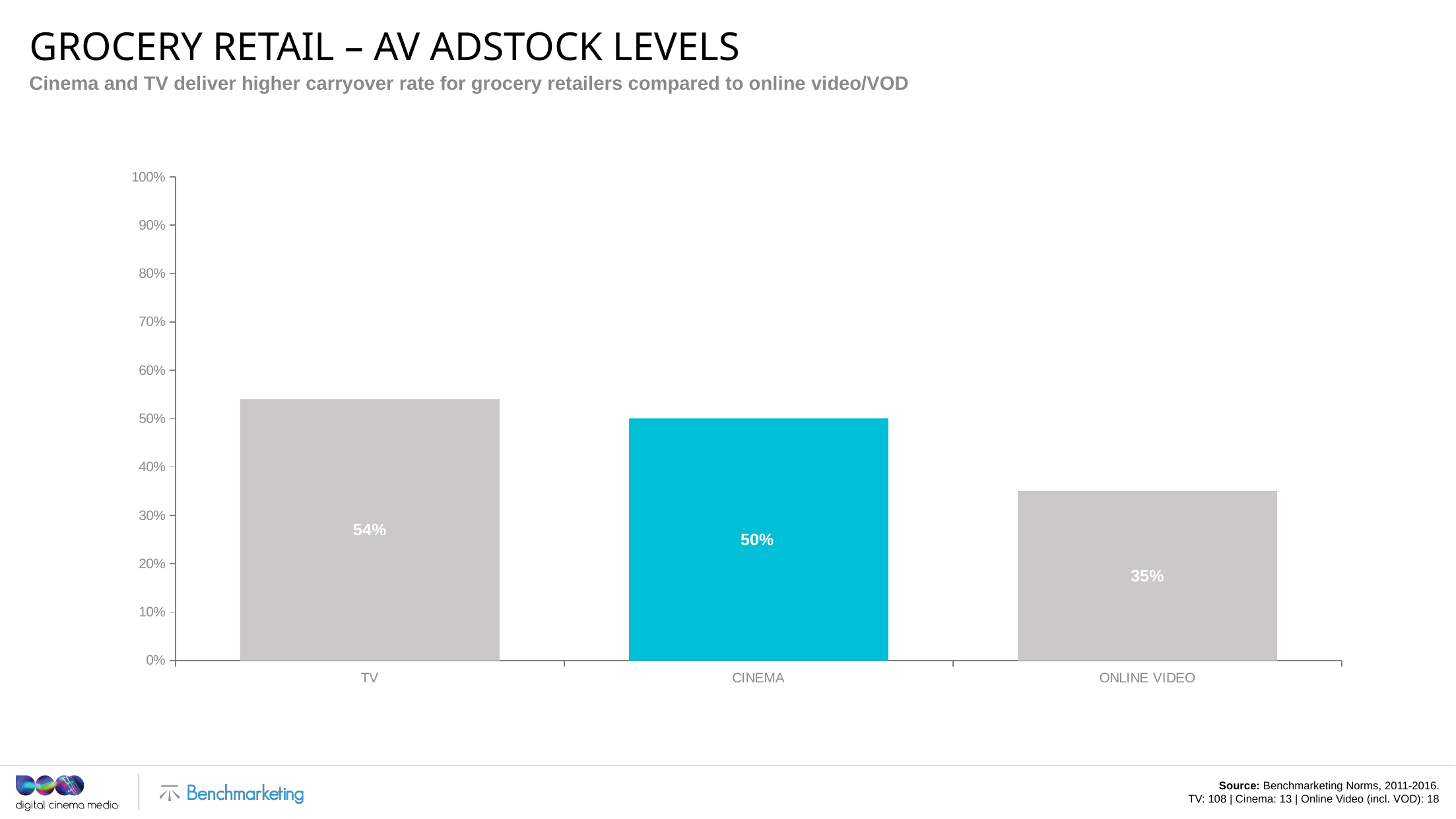
What is the AV adstock level for Online Video? 35% What is the difference between the TV and Online Video adstock levels? 19% Which category has the lowest adstock level? Online Video What is the AV adstock level for TV? 54% What kind of chart is shown on the slide? Bar chart What is the difference between the Cinema and Online Video adstock levels? 15% Which is larger, the adstock level for Cinema or for Online Video? Cinema Which category has the highest adstock level? TV How many categories are shown on the chart? 3 Is the value for Online Video greater or less than 40%? less Which bar is highlighted in a different colour (blue) from the others? Cinema What is the AV adstock level for Cinema? 50%